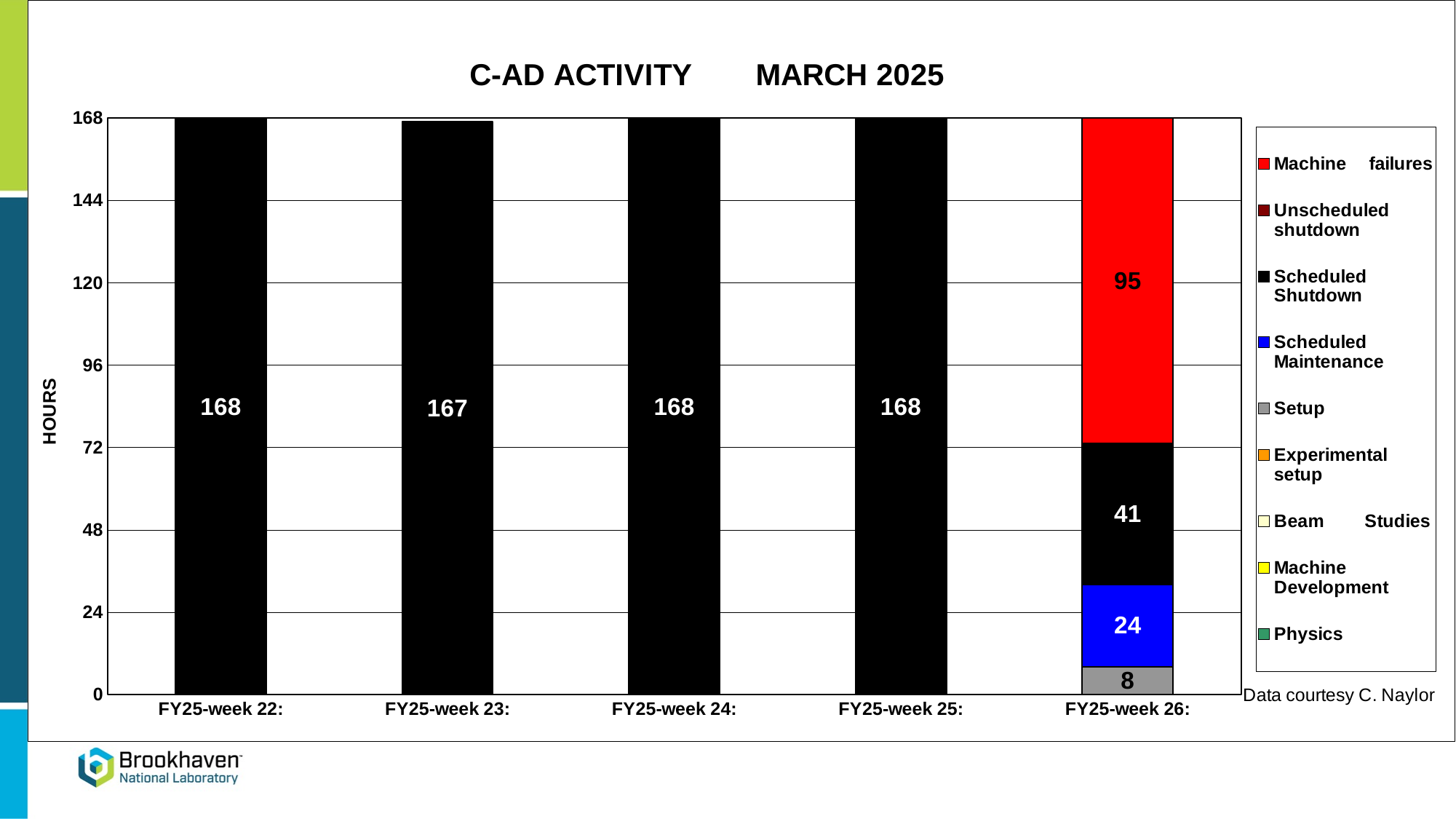
How many hours of Setup are shown for FY25-week 26? 8 In FY25-week 26, which is larger: Scheduled Maintenance or Setup? Scheduled Maintenance What is the title of the chart? C-AD ACTIVITY MARCH 2025 How many series does the legend list? 9 How many hours of Scheduled Maintenance are shown for FY25-week 26? 24 Which week has the lowest Scheduled Shutdown hours? FY25-week 26: What type of chart is shown on the slide? Stacked bar chart What is the difference between the Machine failures hours and the Scheduled Shutdown hours in FY25-week 26? 54 How many hours of Scheduled Shutdown are shown for FY25-week 23? 167 How many weeks (categories) are shown on the x axis? 5 How many hours of Machine failures are shown for FY25-week 26? 95 What is the total number of hours in the stacked bar for FY25-week 26? 168